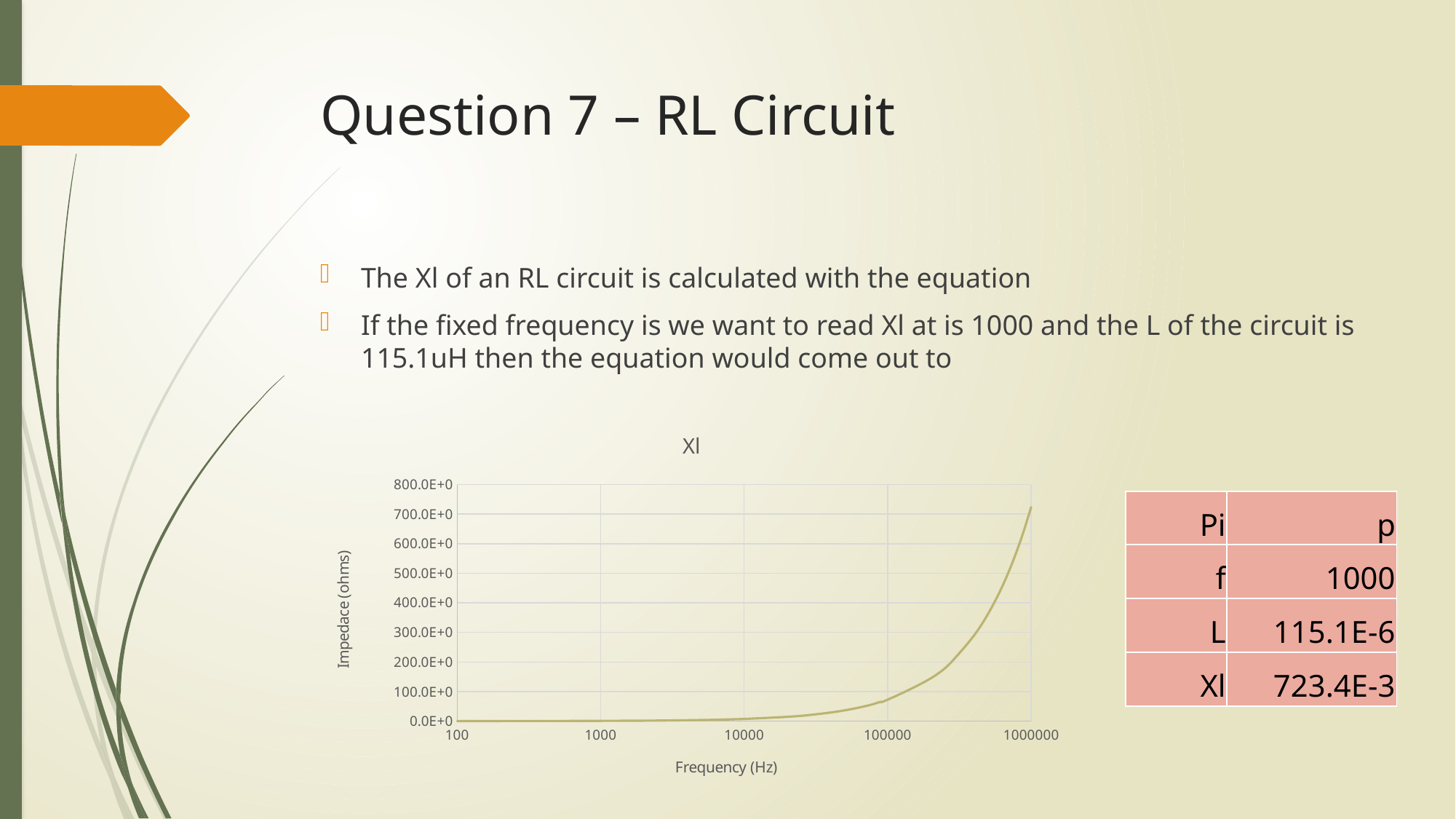
Is the impedance value at 10000 Hz greater or less than 100.0E+0? less Which frequency shown on the x axis has the higher impedance, 100000 Hz or 1000000 Hz? 1000000 Hz Is the impedance value at 100000 Hz greater or less than 100.0E+0? less What is the title of the chart? Xl What is the label of the x axis of the chart? Frequency (Hz) Is the impedance value at 1000000 Hz greater or less than 600.0E+0? greater At which end of the x axis is the impedance lowest, 100 Hz or 1000000 Hz? 100 Hz What kind of chart is shown on the slide? line chart Does the impedance rise or fall as frequency increases along the x axis? rise